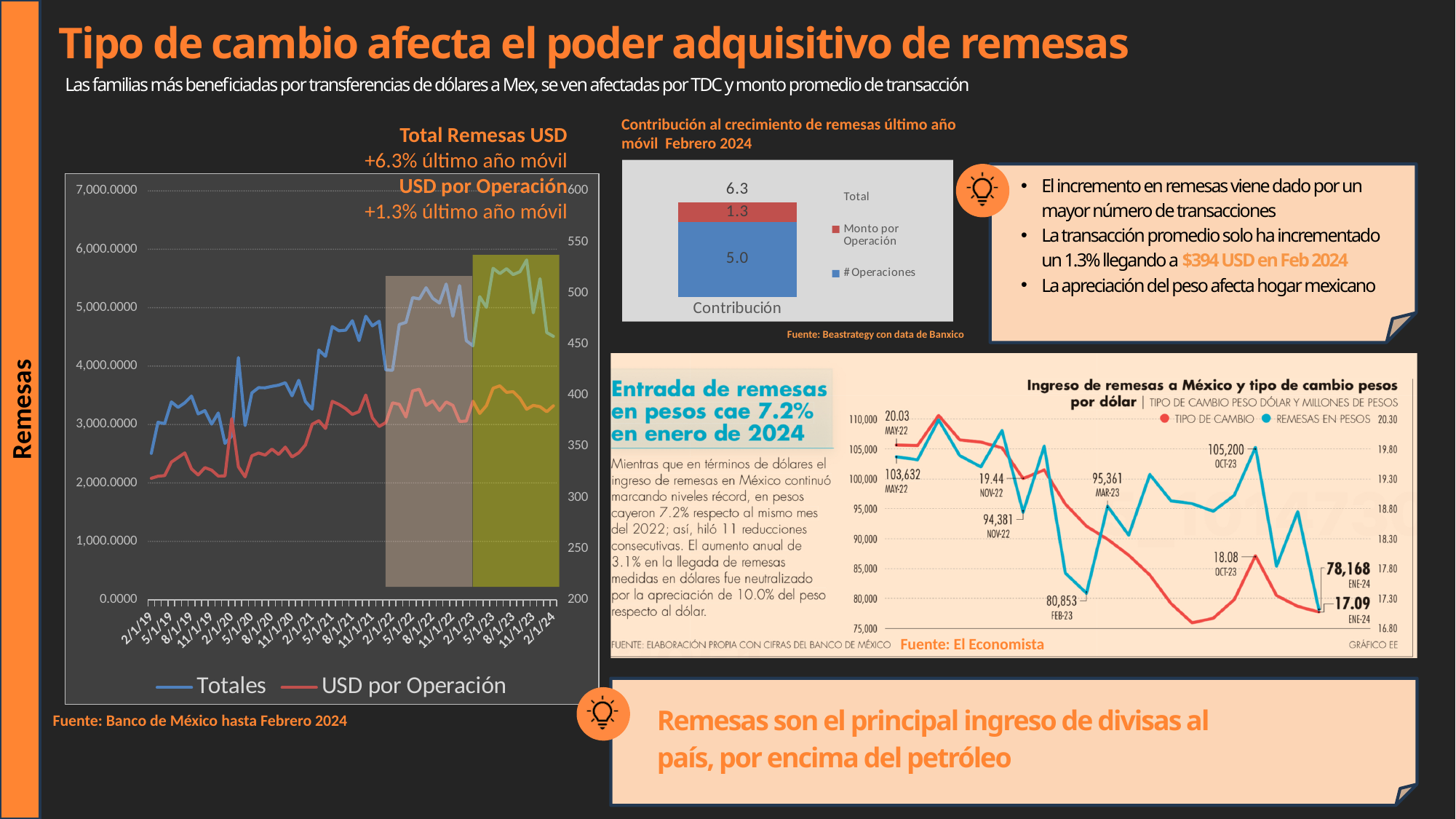
In the left line chart, is the Totales value at 2/1/19 greater or less than 3,000? less In the left line chart, what are the two series listed in the legend? Totales and USD por Operación In the 'Contribución al crecimiento de remesas' chart, what is the value for # Operaciones? 5.0 In the 'Contribución al crecimiento de remesas' chart, what is the total of the stacked bar? 6.3 In the left line chart, does the Totales series generally rise or fall from 2/1/19 to 2/1/24? Rise In the 'Ingreso de remesas a México y tipo de cambio' chart, what is the difference between the OCT-23 remesas value (105,200) and the ENE-24 value (78,168)? 27,032 What kind of chart is the left chart with the Totales and USD por Operación series? Line chart In the 'Ingreso de remesas a México y tipo de cambio' chart, what is the tipo de cambio value labeled for ENE-24? 17.09 In the 'Ingreso de remesas a México y tipo de cambio' chart, what is the remesas en pesos value labeled for ENE-24? 78,168 In the 'Contribución al crecimiento de remesas' chart, which series contributes more, # Operaciones or Monto por Operación? # Operaciones In the 'Contribución al crecimiento de remesas' chart, what is the value for Monto por Operación? 1.3 In the 'Contribución al crecimiento de remesas' chart, how many series does the legend list? 3